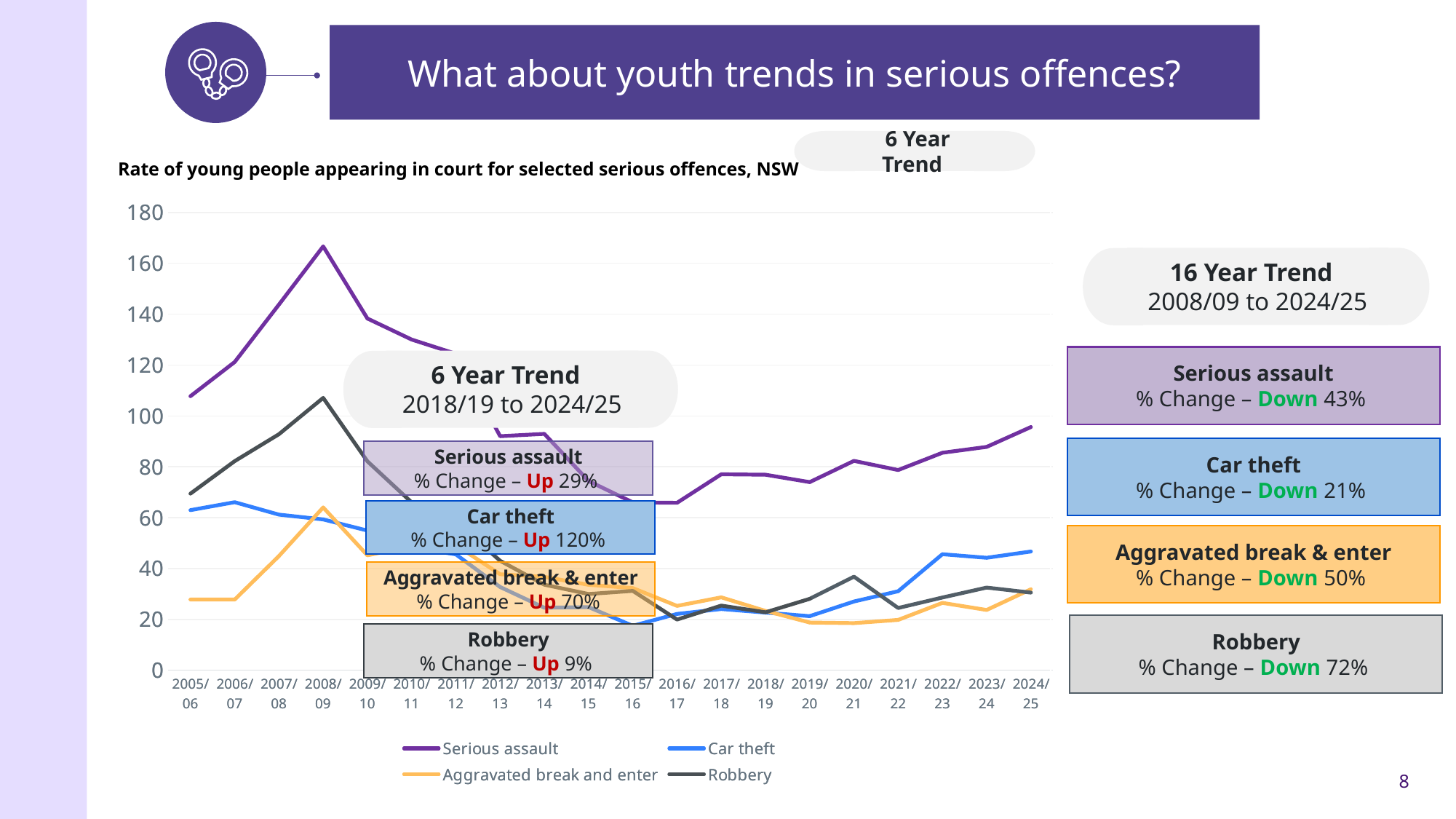
What kind of chart is shown on the slide? Line chart Is the value for Car theft in 2024/25 greater or less than 40? greater What is the title of the chart? Rate of young people appearing in court for selected serious offences, NSW Is the value for Robbery in 2008/09 greater or less than 100? greater Is the value for Serious assault in 2024/25 greater or less than 100? less Which series has the highest value in 2024/25? Serious assault How many financial-year points are shown along the x axis of the chart? 20 How many series does the chart legend list? 4 In 2024/25, which is larger: Car theft or Aggravated break and enter? Car theft Does the Serious assault line rise or fall between 2008/09 and 2015/16? Fall In which year does the Serious assault line reach its highest value? 2008/09